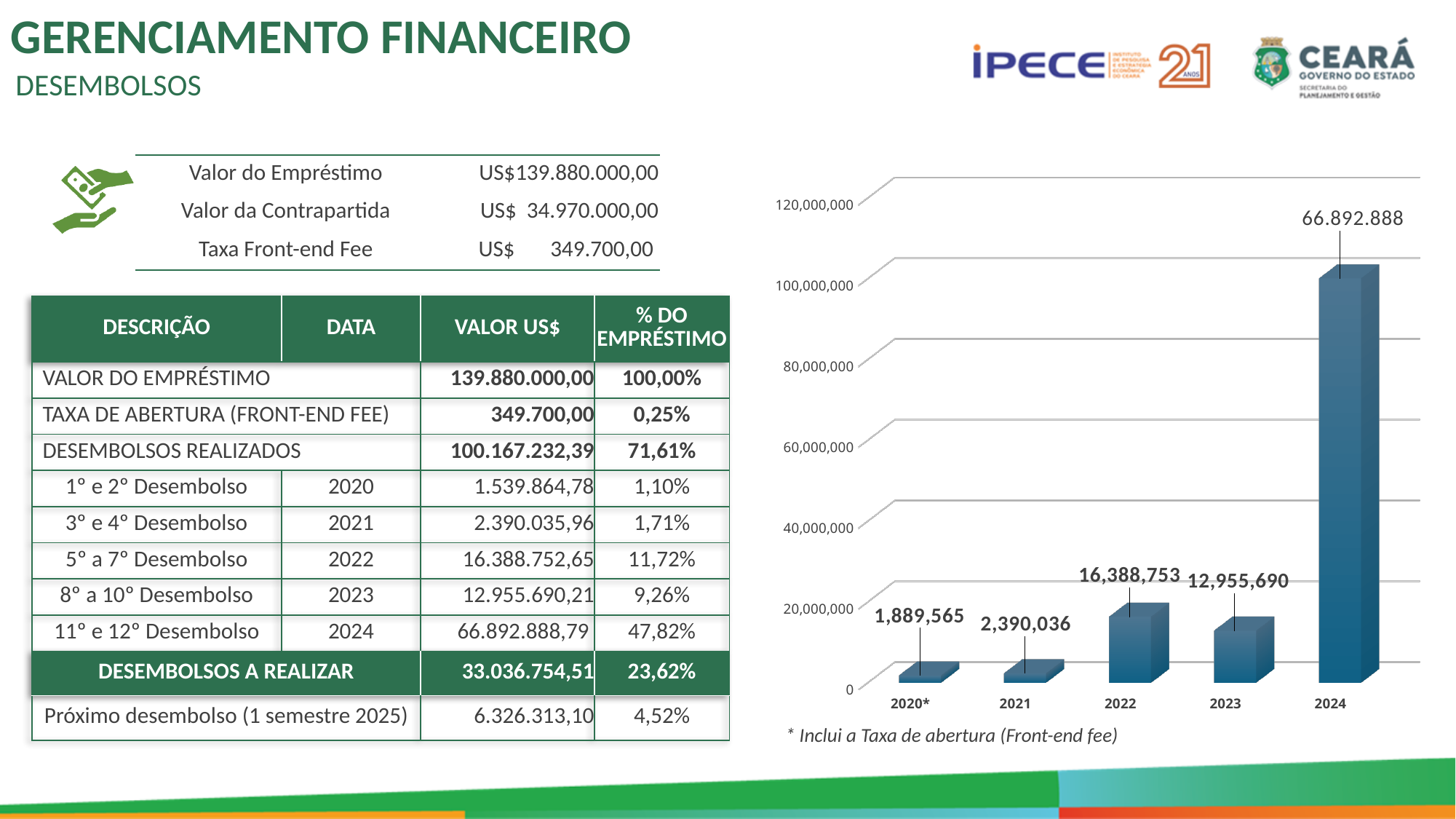
Which year has the lowest value in the bar chart? 2020* How many years (categories) are shown on the x axis of the bar chart? 5 In the bar chart, what is the difference between the values for 2022 and 2023? 3,433,063 What is the value shown for 2020* in the bar chart? 1,889,565 What type of chart is shown on the right side of the slide? bar chart What is the value shown for 2022 in the bar chart? 16,388,753 In the bar chart, which is larger: the value for 2022 or the value for 2023? 2022 What does the asterisk on the 2020* label in the bar chart indicate, according to the note below the chart? Inclui a Taxa de abertura (Front-end fee) Which year has the highest value in the bar chart? 2024 Is the value for 2024 in the bar chart greater or less than 60,000,000? greater What is the value shown for 2021 in the bar chart? 2,390,036 What is the value shown for 2023 in the bar chart? 12,955,690